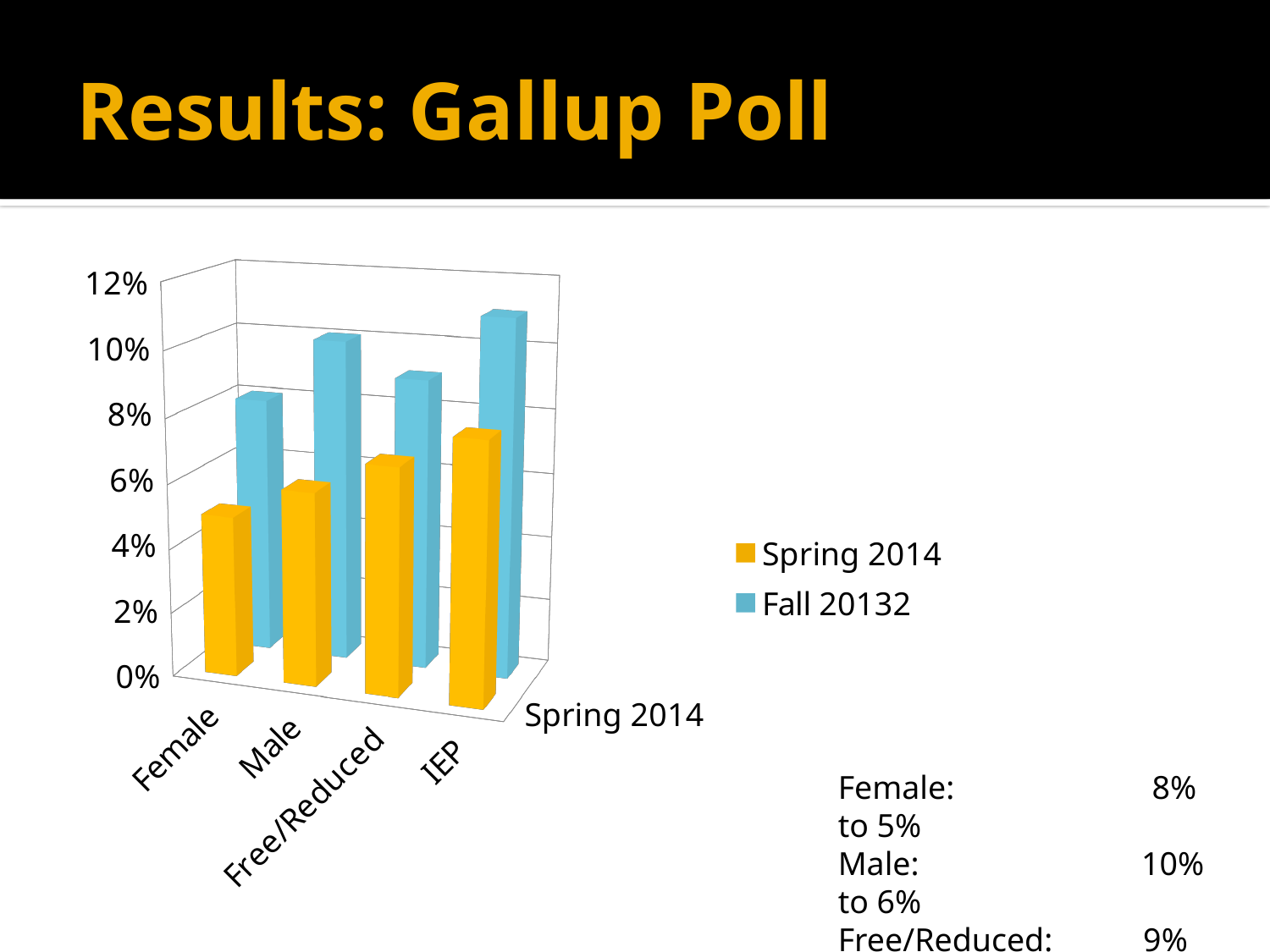
What is the Fall 20132 value for Free/Reduced? 9% Which category has the lowest Spring 2014 value? Female How many categories are shown on the x axis of the chart? 4 How many series does the chart legend list? 2 For Female, which series has the larger value, Spring 2014 or Fall 20132? Fall 20132 What is the difference between the Fall 20132 and Spring 2014 values for Male? 4% Is the Spring 2014 value for IEP greater or less than 4%? greater Which category has the highest Fall 20132 value? IEP What colour are the Spring 2014 bars in the chart? yellow What is the Spring 2014 value for Male? 6% What kind of chart is shown on the slide? bar chart What is the Fall 20132 value for Female? 8%